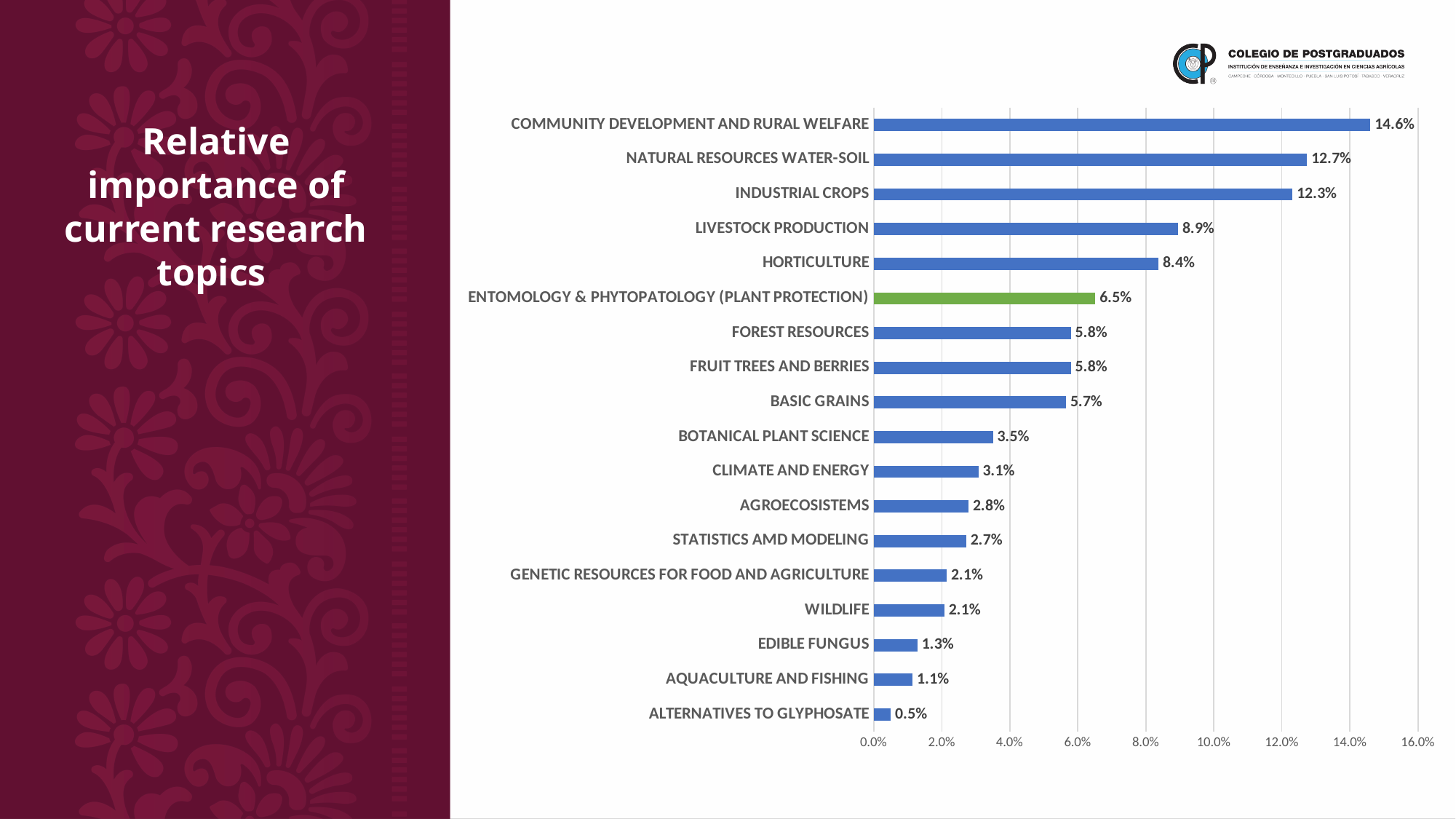
Which category's bar is coloured green instead of blue? Entomology & Phytopatology (Plant Protection) Which category has the highest value? Community Development and Rural Welfare How many categories are shown in the chart? 18 What is the difference between the values for Natural Resources Water-Soil and Industrial Crops? 0.4% Which category has the lowest value? Alternatives to Glyphosate What kind of chart is shown on the slide? bar chart What is the value for Livestock Production? 8.9% What is the value for Edible Fungus? 1.3% Is the value for Community Development and Rural Welfare greater or less than 14.0%? greater Which is larger, the value for Horticulture or the value for Basic Grains? Horticulture What is the value for Entomology & Phytopatology (Plant Protection)? 6.5% What is the title of the slide containing the chart? Relative importance of current research topics